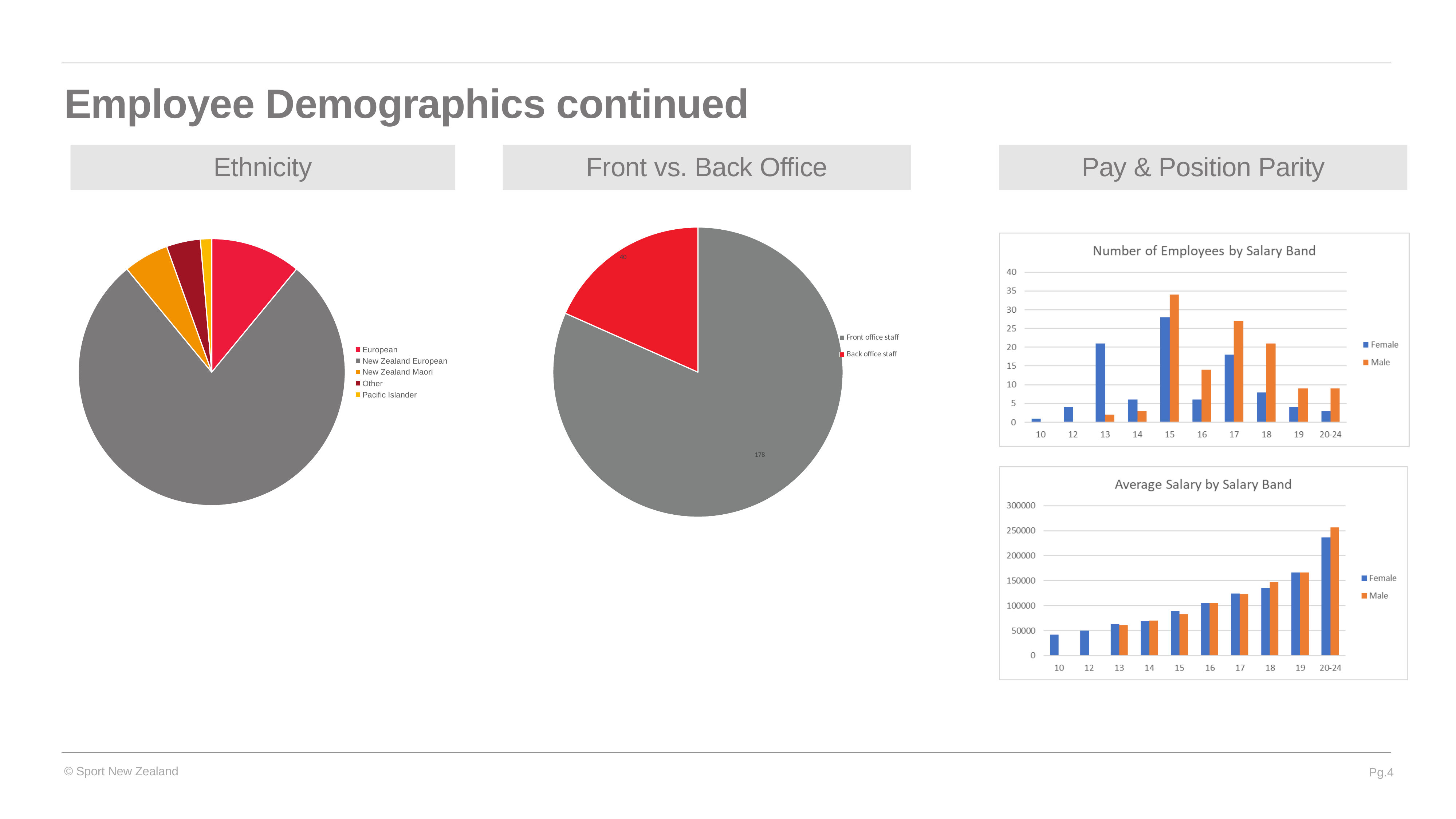
How many ethnicity categories does the Ethnicity pie chart show? 5 In the Ethnicity pie chart, which category has the smallest slice? Pacific Islander In the Number of Employees by Salary Band chart, is the Male value for salary band 15 greater or less than 30? greater How many series does the legend of the Number of Employees by Salary Band chart list? 2 In the Front vs. Back Office pie chart, what is the difference between Front office staff and Back office staff? 138 In the Front vs. Back Office pie chart, what is the value for Front office staff? 178 In the Ethnicity pie chart, which category has the largest slice? New Zealand European In the Front vs. Back Office pie chart, what is the total of the two slices? 218 What kind of chart is the Ethnicity chart? Pie chart In the Front vs. Back Office pie chart, what is the value for Back office staff? 40 In the Average Salary by Salary Band chart, do the values rise or fall as the salary band increases? rise In the Number of Employees by Salary Band chart, which salary band has the highest Male bar? 15